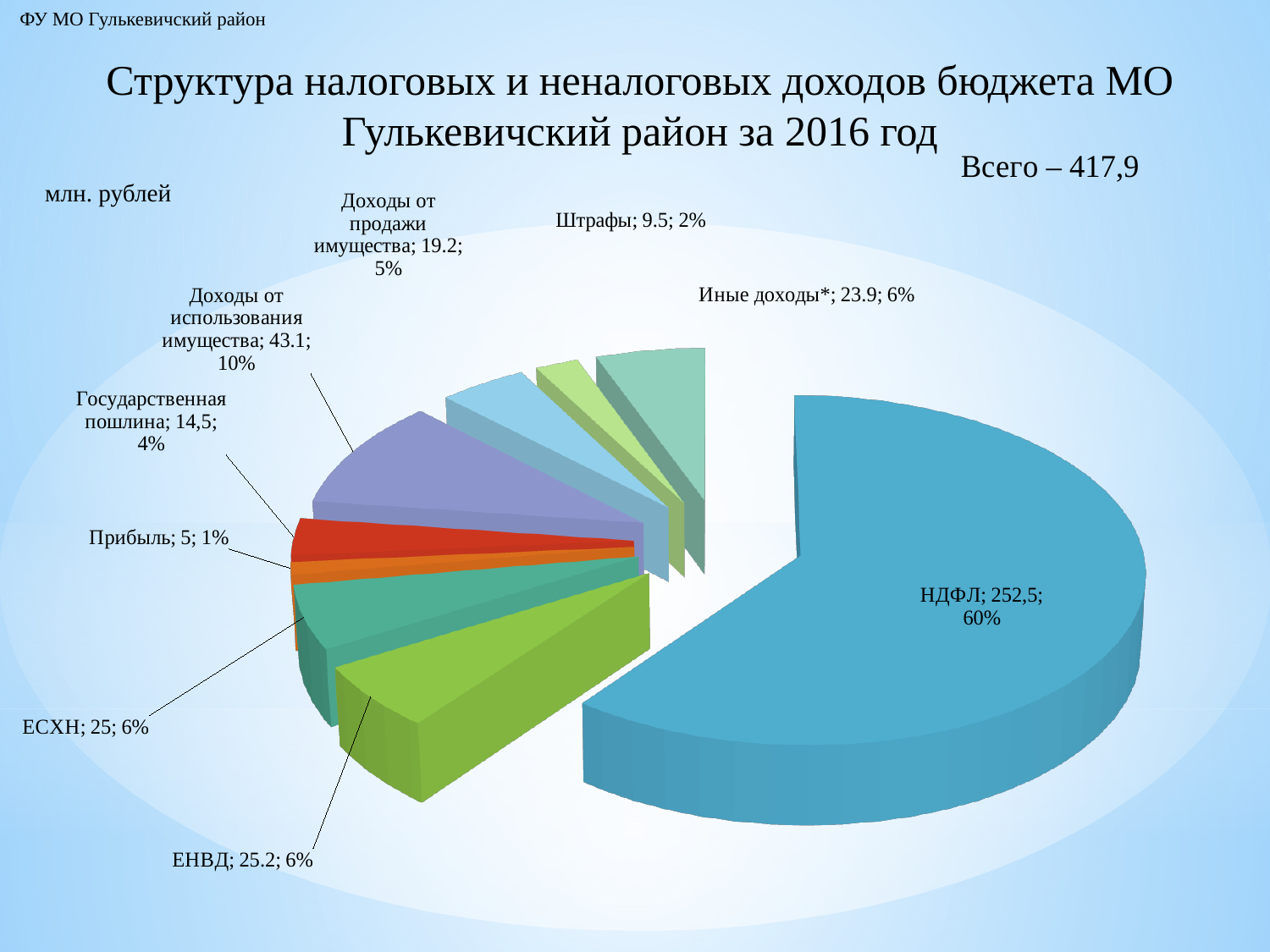
What is the difference between the values for Доходы от использования имущества and Доходы от продажи имущества? 23.9 What share of the pie does Штрафы take? 2% Which is larger, ЕНВД or Государственная пошлина? ЕНВД What total is stated on the slide for the chart (Всего)? 417,9 Which category has the largest slice? НДФЛ What kind of chart is shown on the slide? pie chart What is the value for Иные доходы*? 23.9 What is the value for НДФЛ? 252,5 What is the value for Доходы от использования имущества? 43.1 What share of the pie does НДФЛ take? 60% How many slices does the pie chart have? 9 Which category has the smallest slice? Прибыль